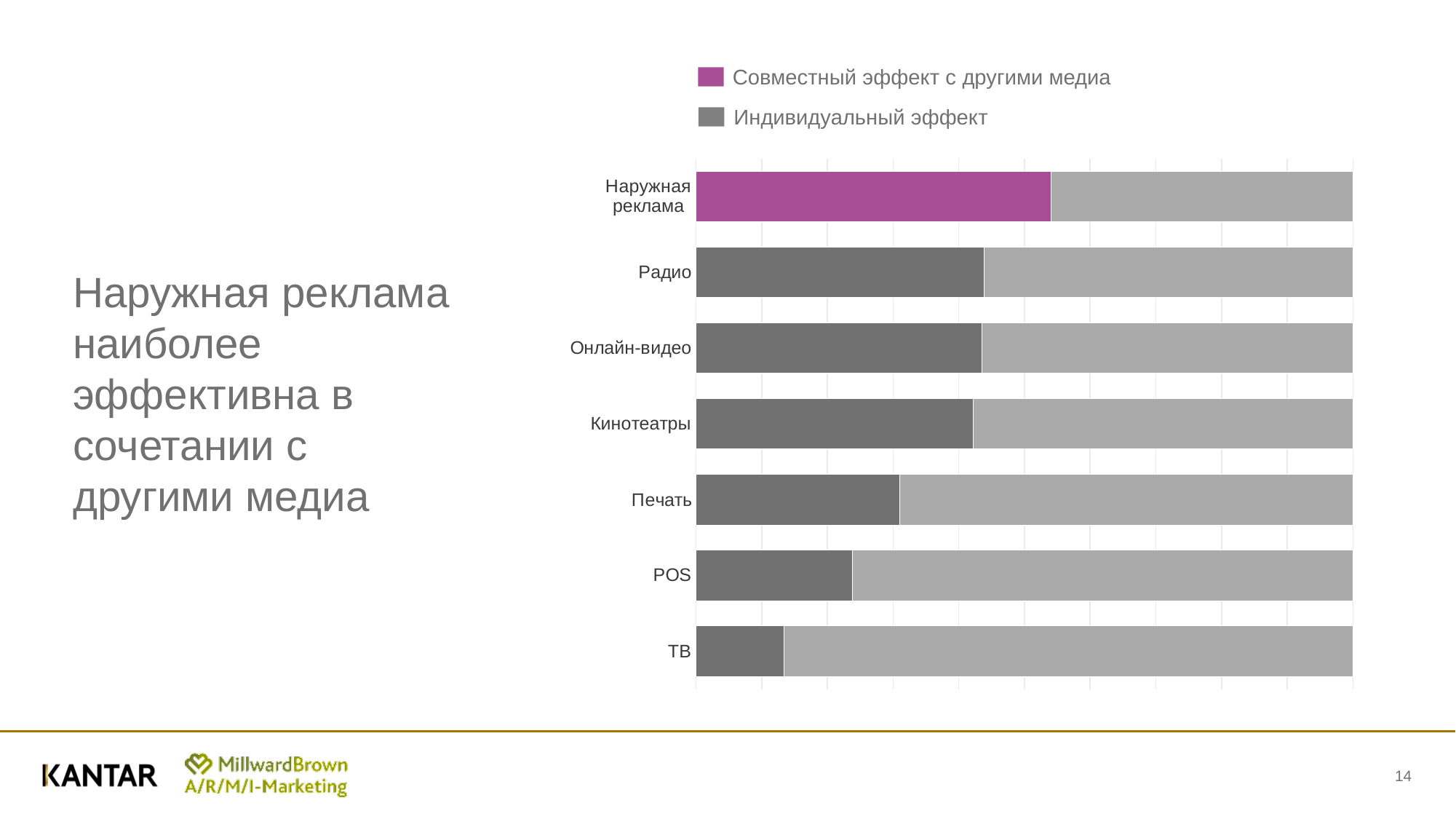
Which category is listed at the bottom of the chart? ТВ Going from the top category to the bottom, does the 'Совместный эффект с другими медиа' segment increase or decrease? Decrease Which has a larger 'Совместный эффект с другими медиа' segment, POS or ТВ? POS How many series does the chart legend list? 2 Which category's bar is highlighted in purple? Наружная реклама Which category has the smallest 'Совместный эффект с другими медиа' segment? ТВ What kind of chart is shown on the slide? Stacked bar chart Which has a larger 'Совместный эффект с другими медиа' segment, Печать or POS? Печать Which has a larger 'Совместный эффект с другими медиа' segment, Наружная реклама or Кинотеатры? Наружная реклама Which category has the largest 'Совместный эффект с другими медиа' segment? Наружная реклама How many media categories are plotted in the chart? 7